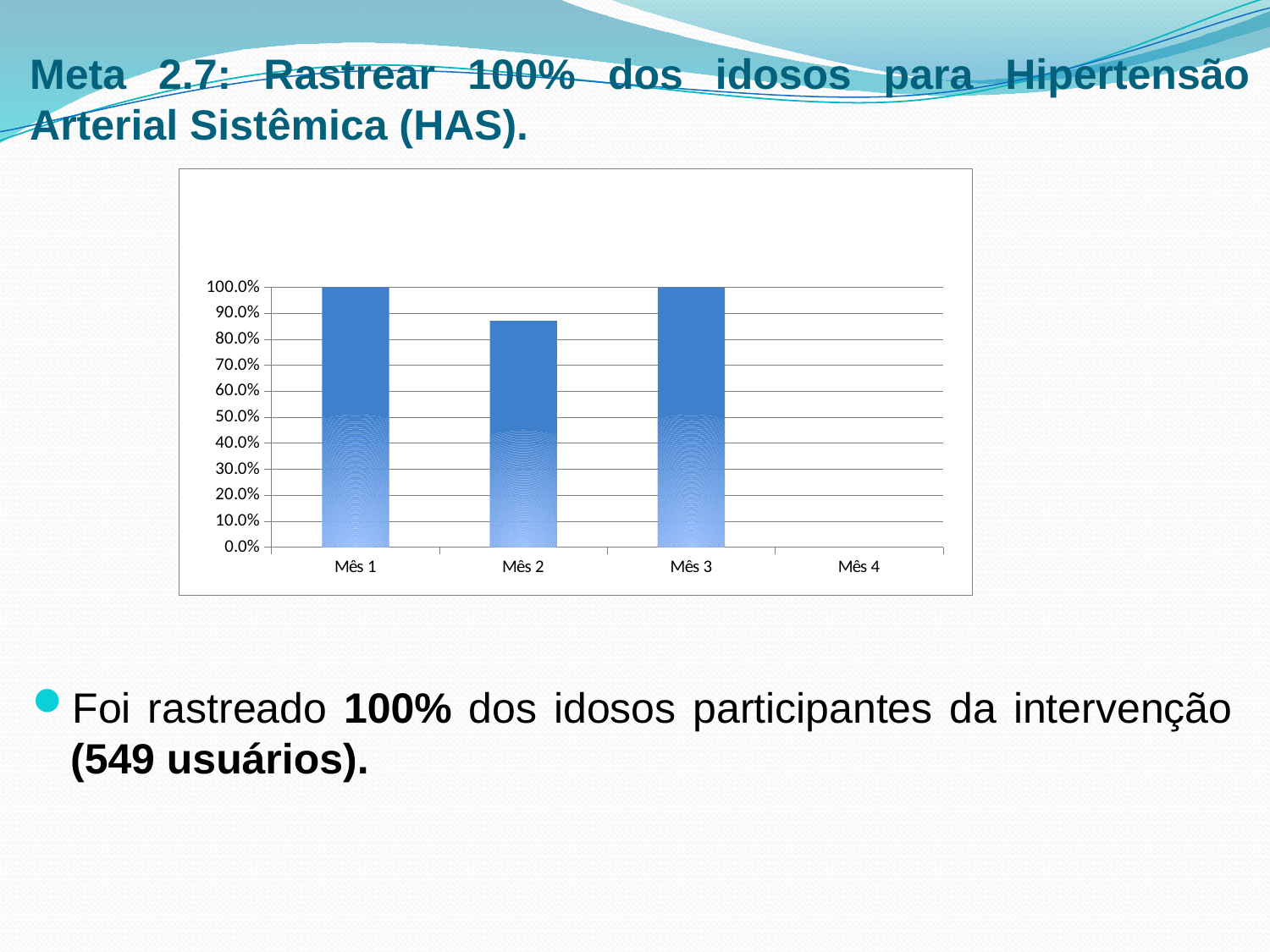
Which is larger, the value for Mês 1 or the value for Mês 2? Mês 1 What kind of chart is shown on the slide? bar chart Among Mês 1, Mês 2 and Mês 3, which month has the lowest value? Mês 2 Which category on the x axis has no bar shown? Mês 4 How many categories are shown on the x axis of the chart? 4 Is the value for Mês 2 greater or less than 80.0%? greater Is the value for Mês 2 greater or less than 90.0%? less What is the highest tick label on the y axis of the chart? 100.0% What is the value for Mês 3? 100.0% Which is larger, the value for Mês 2 or the value for Mês 3? Mês 3 What is the value for Mês 1? 100.0%